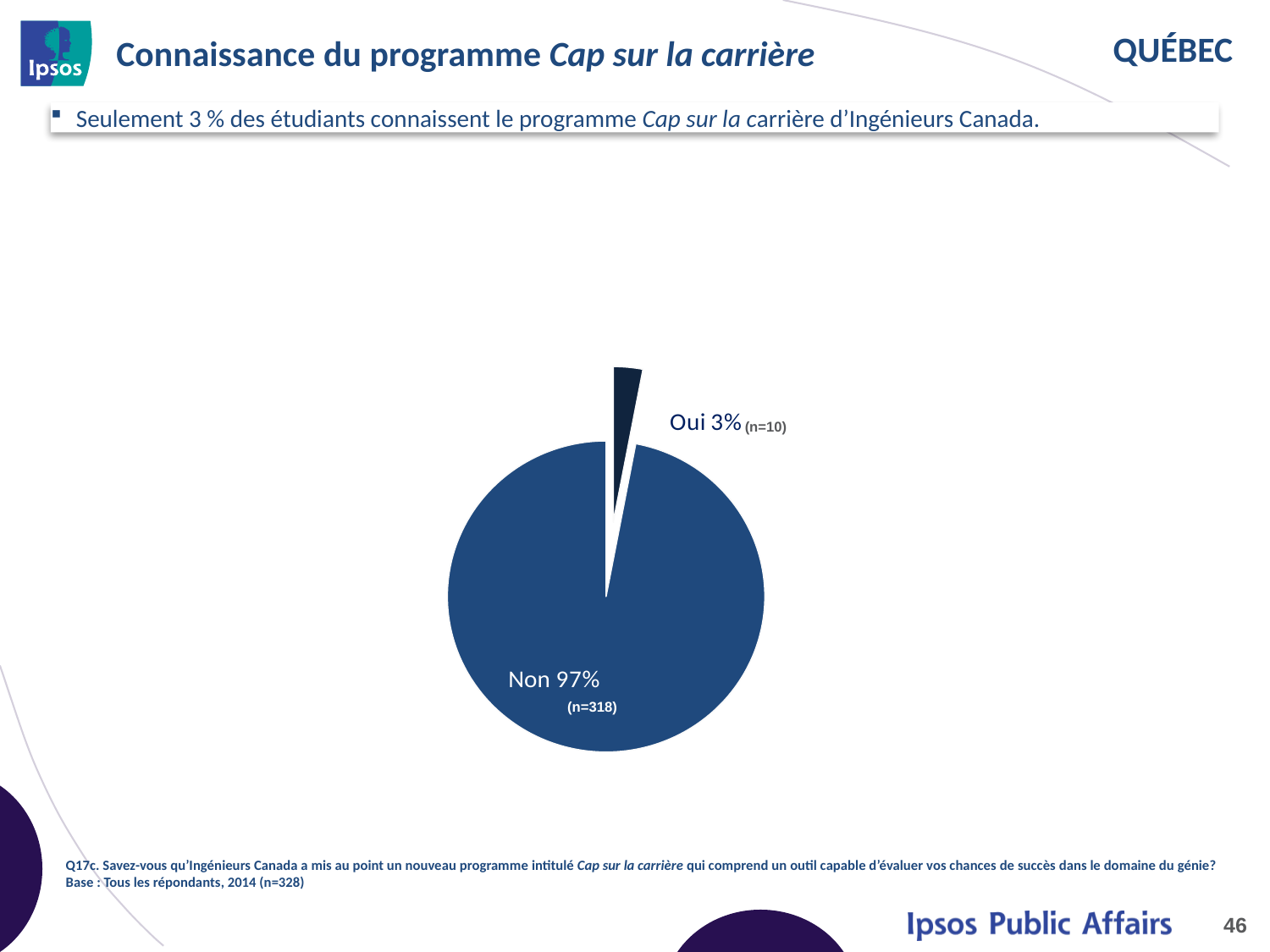
What percentage of respondents answered "Oui"? 3% How many respondents answered "Non" (n)? n=318 Which slice of the pie is the smallest? Oui Which slice of the pie is the largest? Non What percentage of respondents answered "Non"? 97% How many respondents answered "Oui" (n)? n=10 Which is larger, the "Oui" slice or the "Non" slice? Non What is the total number of respondents shown in the base of the chart? n=328 What share of the pie does the "Non" slice represent? 97% What is the difference in percentage points between the "Non" and "Oui" slices? 94 How many slices does the pie chart have? 2 What kind of chart is shown on the slide? pie chart